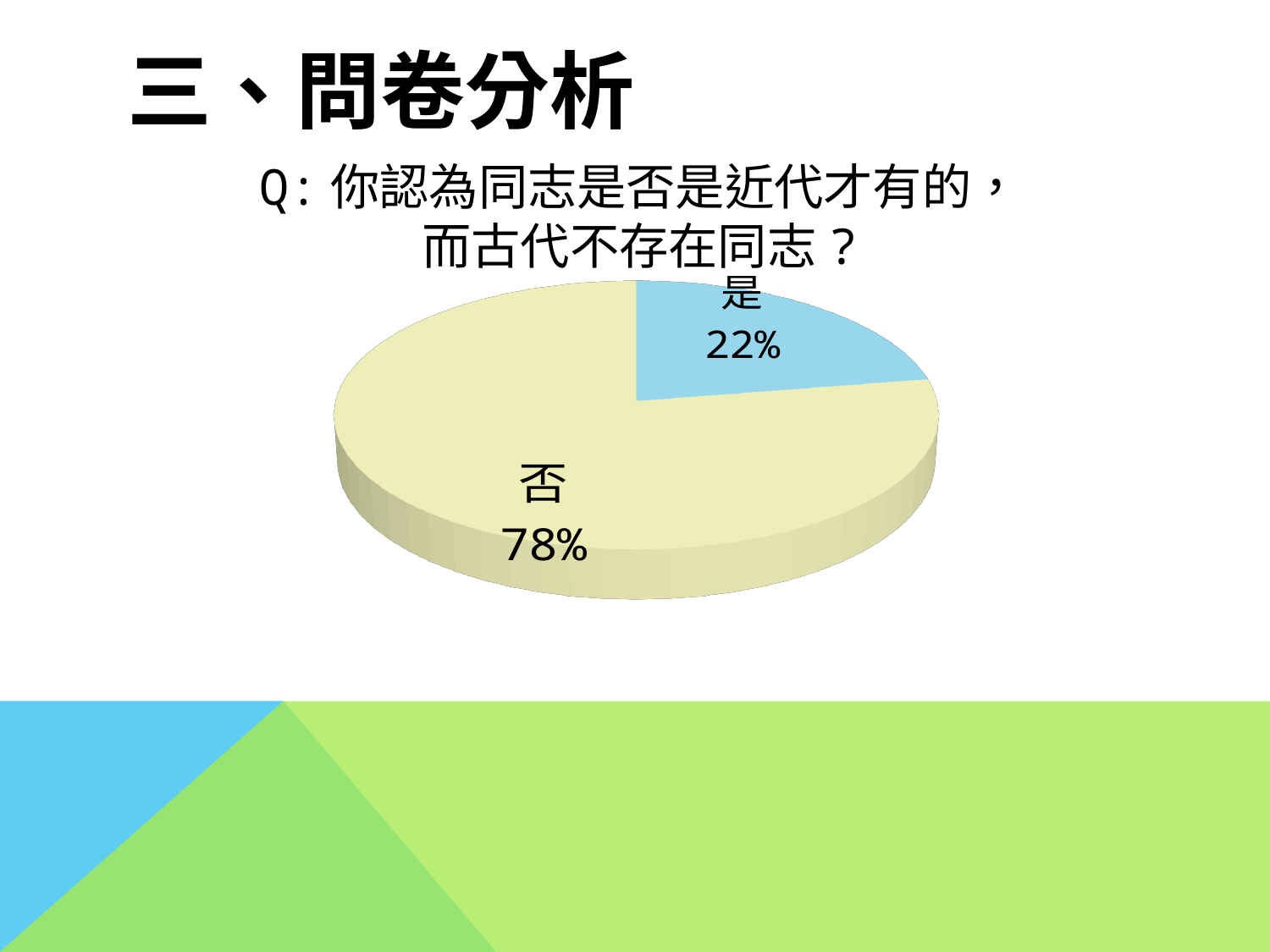
What kind of chart is shown on the slide? pie chart What is the difference in percentage points between the 否 and 是 slices? 56 What share of the pie does the 是 slice represent? 22% What percentage of respondents answered 是 (yes)? 22% What percentage of respondents answered 否 (no)? 78% Which response has the smallest share of the pie? 是 What colour is the 是 slice? light blue Which response has the largest share of the pie? 否 What question does the pie chart summarise responses to? 你認為同志是否是近代才有的，而古代不存在同志？ Which slice is larger, 是 or 否? 否 How many slices does the pie chart have? 2